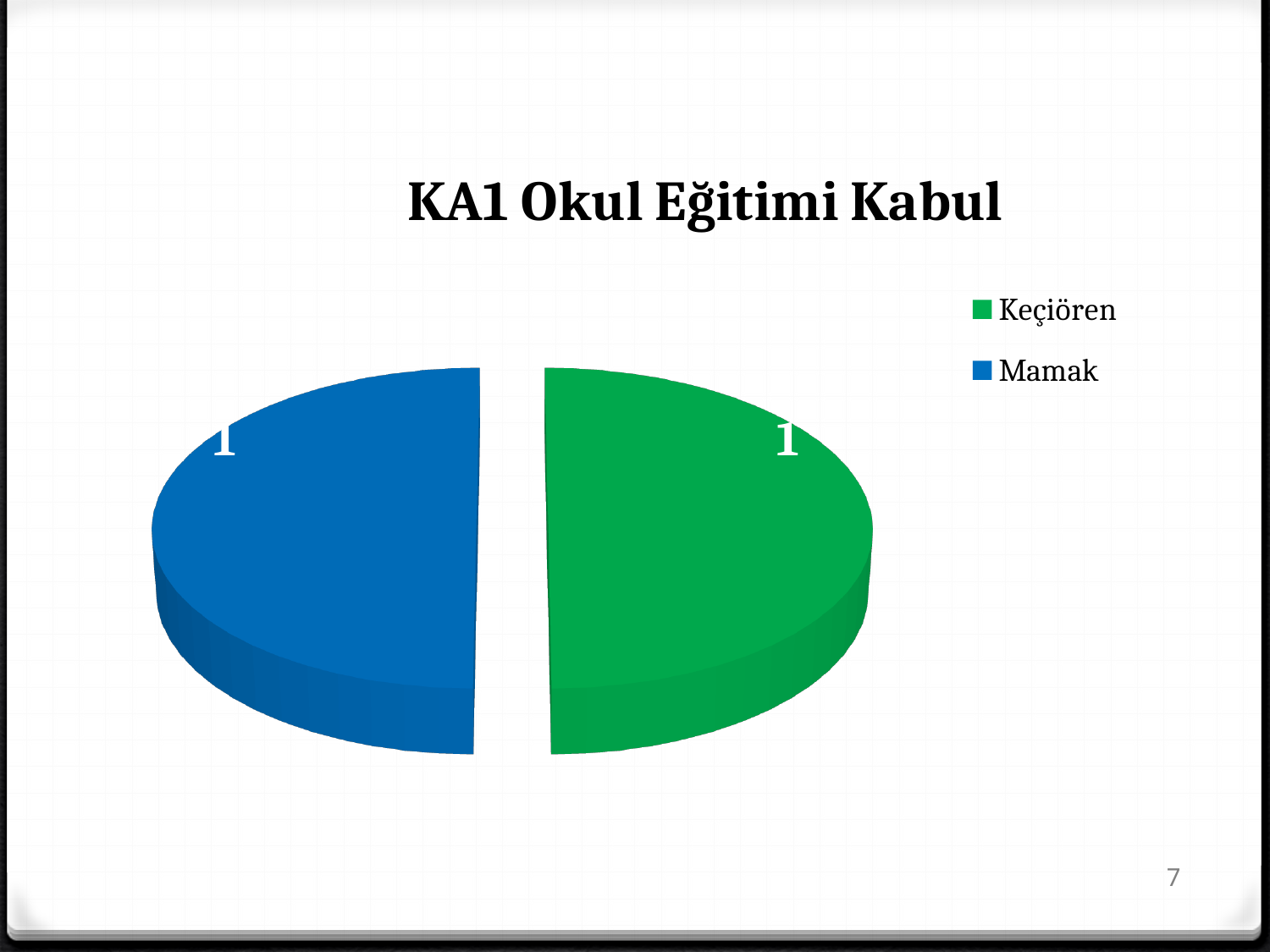
What is the value for Keçiören? 1 What is the value for Mamak? 1 Which colour represents Mamak in the chart? blue What is the difference between the values for Keçiören and Mamak? 0 What share of the pie does Mamak represent? 50% What is the title of the chart? KA1 Okul Eğitimi Kabul What kind of chart is shown on the slide? pie chart How many entries does the legend list? 2 What share of the pie does Keçiören represent? 50% How many slices does the pie chart have? 2 What is the total of all slices in the pie chart? 2